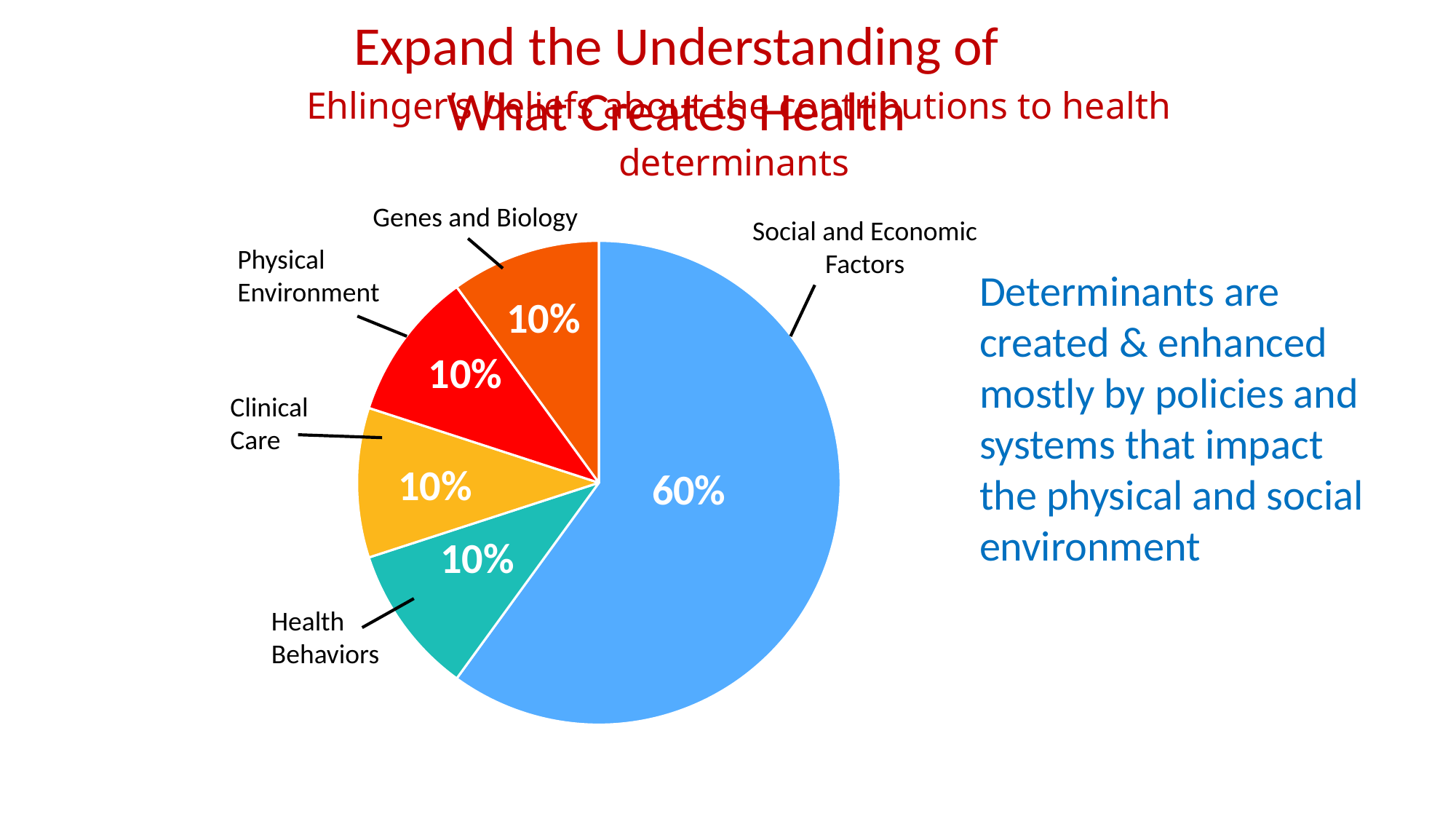
What is the difference in percentage points between Social and Economic Factors and Clinical Care? 50 percentage points What share of the pie do the four 10% slices make up together? 40% What percentage of the pie chart is Social and Economic Factors? 60% What type of chart is shown on the slide? Pie chart What value is shown for Clinical Care in the pie chart? 10% Which is larger, the Social and Economic Factors slice or the Genes and Biology slice? Social and Economic Factors Which category has the largest slice of the pie chart? Social and Economic Factors What percentage does the Health Behaviors slice represent? 10% What colour is the Social and Economic Factors slice? Blue What percentage is shown for Genes and Biology? 10% How many slices does the pie chart have? 5 What percentage is labelled on the Physical Environment slice? 10%